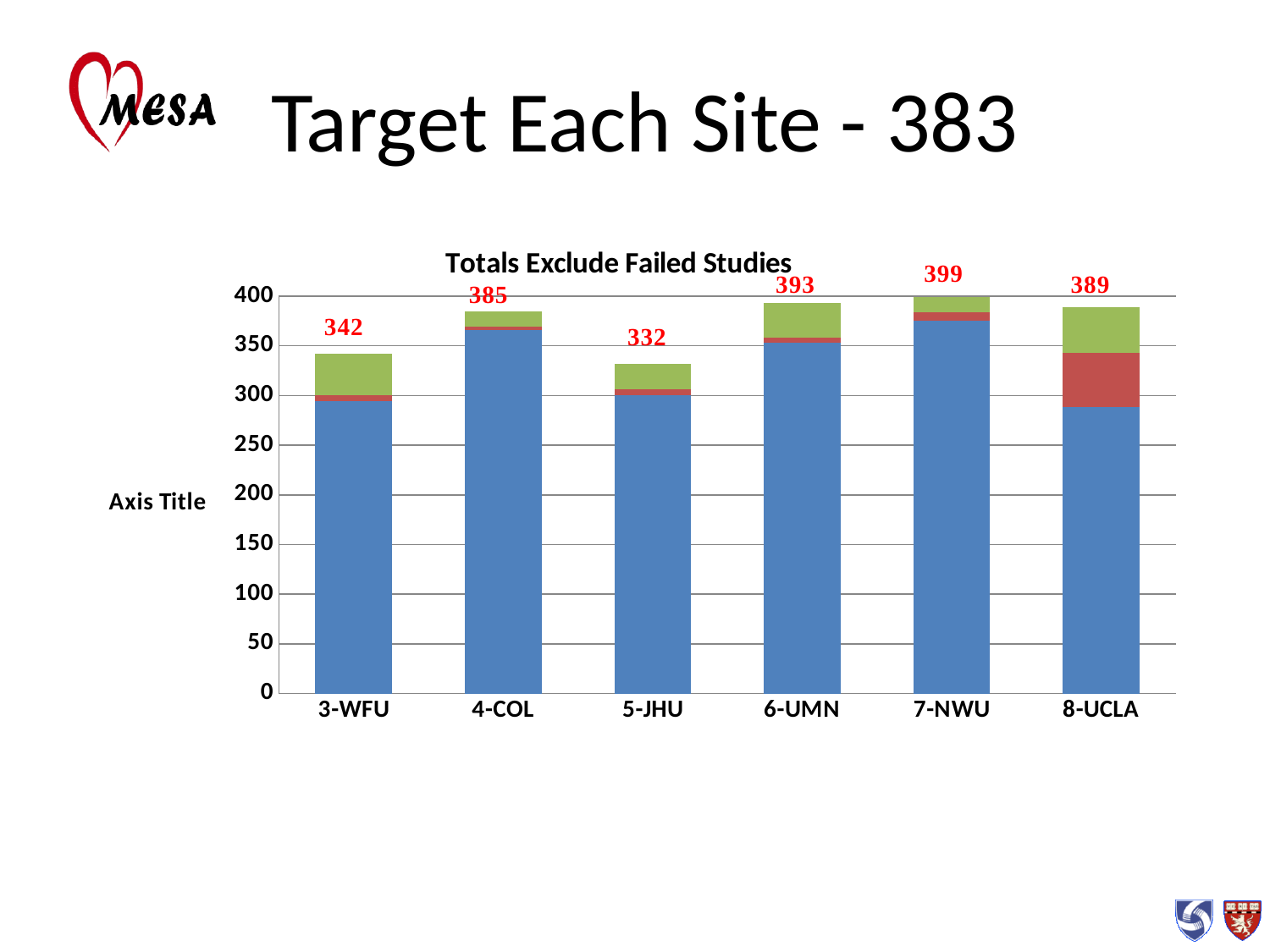
Which site has the lowest total? 5-JHU Is the blue segment for 8-UCLA greater or less than 300? less Which has a larger total, 4-COL or 8-UCLA? 8-UCLA What is the title of the chart? Totals Exclude Failed Studies What is the total labelled for 6-UMN? 393 What is the difference between the totals for 7-NWU and 5-JHU? 67 Which site has the highest total? 7-NWU What kind of chart is shown on the slide? stacked bar chart What is the difference between the totals for 4-COL and 3-WFU? 43 How many sites are shown on the x axis? 6 What is the total labelled for 3-WFU? 342 What is the total labelled for 8-UCLA? 389